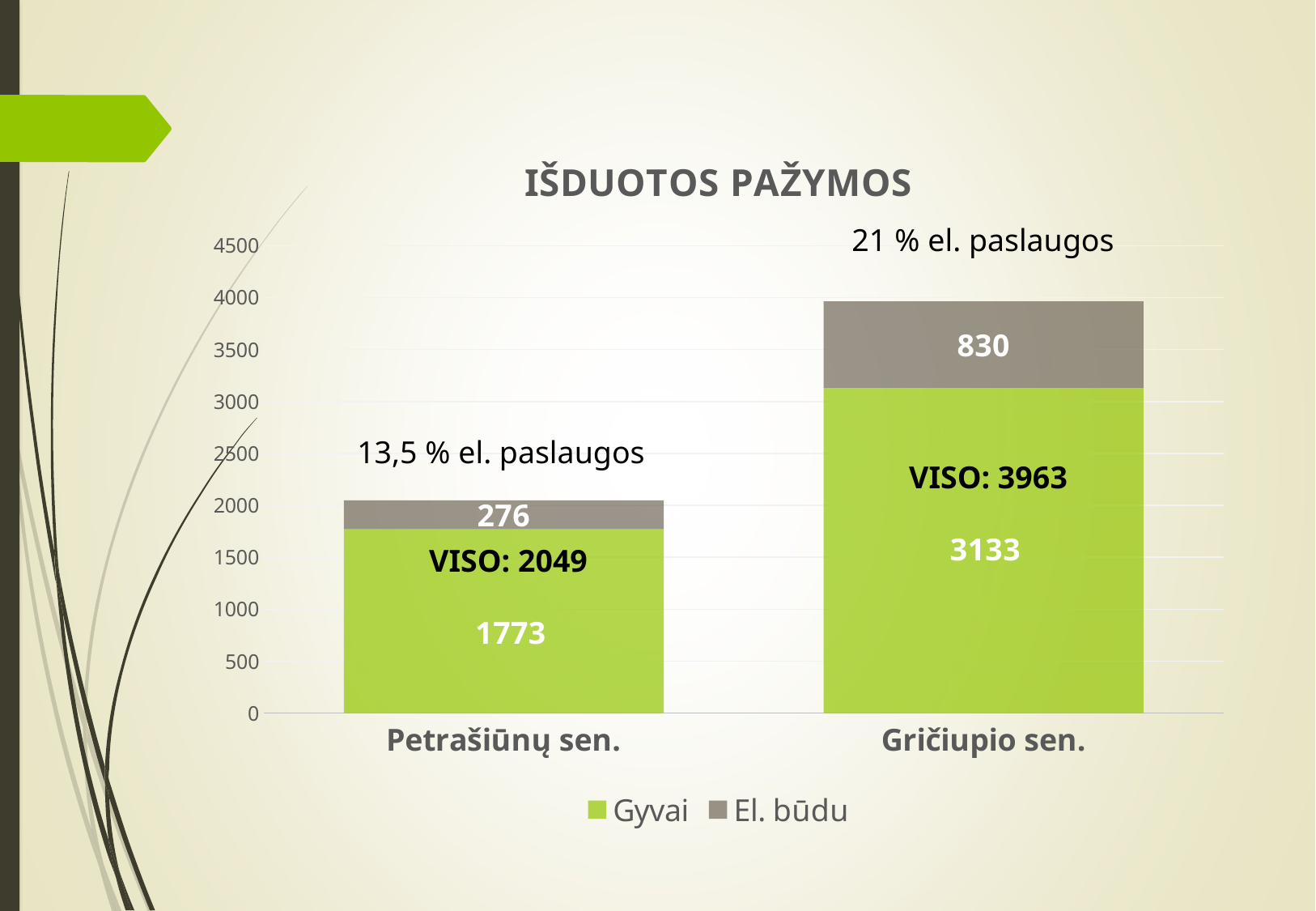
Is the Gyvai value for Gričiupio sen. greater or less than 3000? greater What is the value for El. būdu in Gričiupio sen.? 830 What is the total of the stacked bar for Petrašiūnų sen.? 2049 What is the value for Gyvai in Gričiupio sen.? 3133 What is the value for El. būdu in Petrašiūnų sen.? 276 How many series does the legend list? 2 Which category has the higher Gyvai value? Gričiupio sen. What kind of chart is shown? Stacked bar chart How many categories are shown on the x axis? 2 What is the value for Gyvai in Petrašiūnų sen.? 1773 What is the total of the stacked bar for Gričiupio sen.? 3963 What is the difference between the El. būdu values for Gričiupio sen. and Petrašiūnų sen.? 554